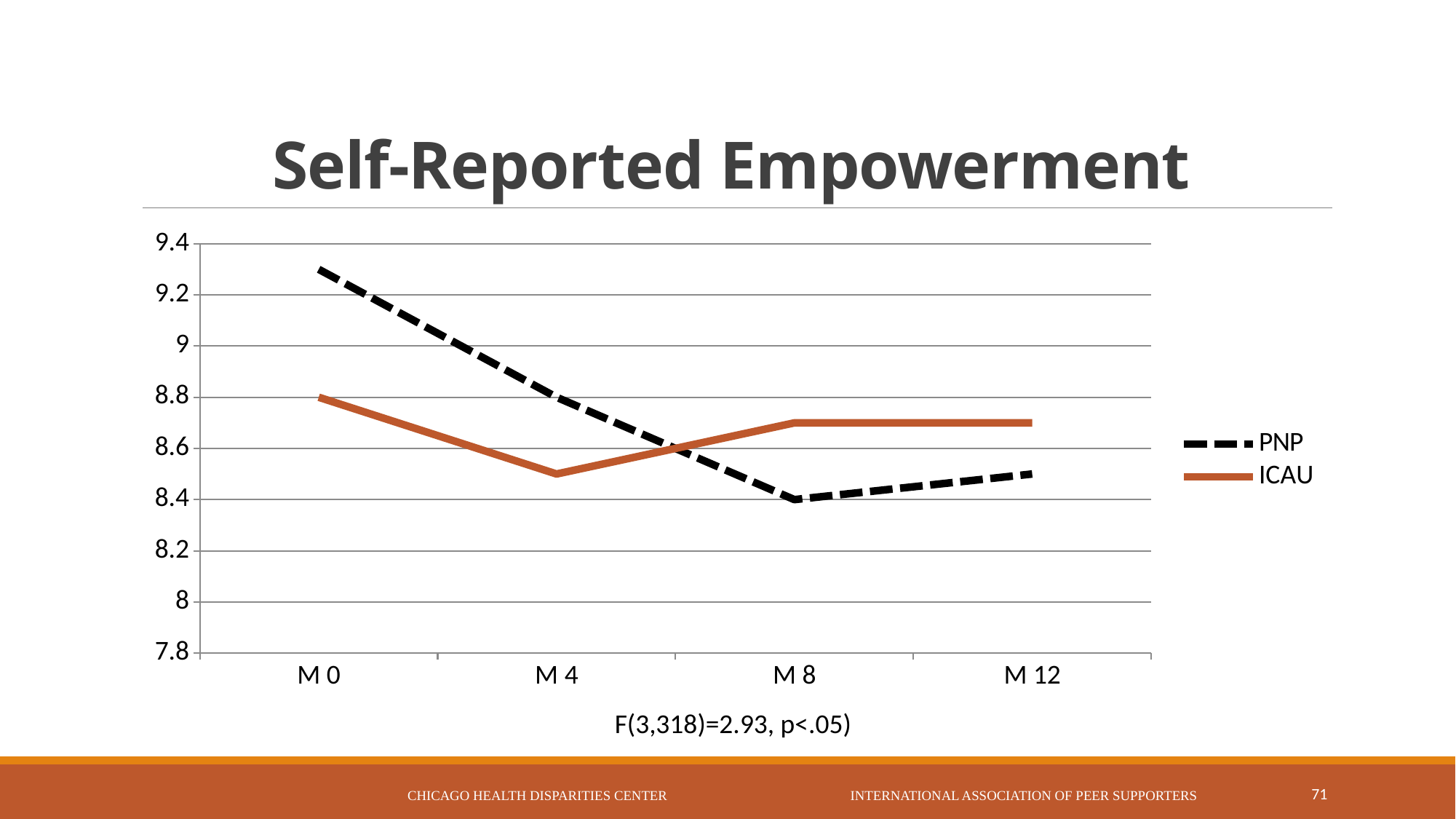
How many series does the legend list? 2 Which series is drawn with a dashed black line? PNP Is the ICAU value at M 4 greater or less than 8.6? less At which time point is the PNP series lowest? M 8 At M 0, which series has the higher value, PNP or ICAU? PNP What kind of chart is shown on the slide? line chart Is the PNP value at M 0 greater or less than 9.2? greater At which time point is the PNP series highest? M 0 How many time points are plotted along the x axis? 4 What is the title of the chart? Self-Reported Empowerment At which time point is the ICAU series lowest? M 4 At M 8, which series has the higher value, PNP or ICAU? ICAU